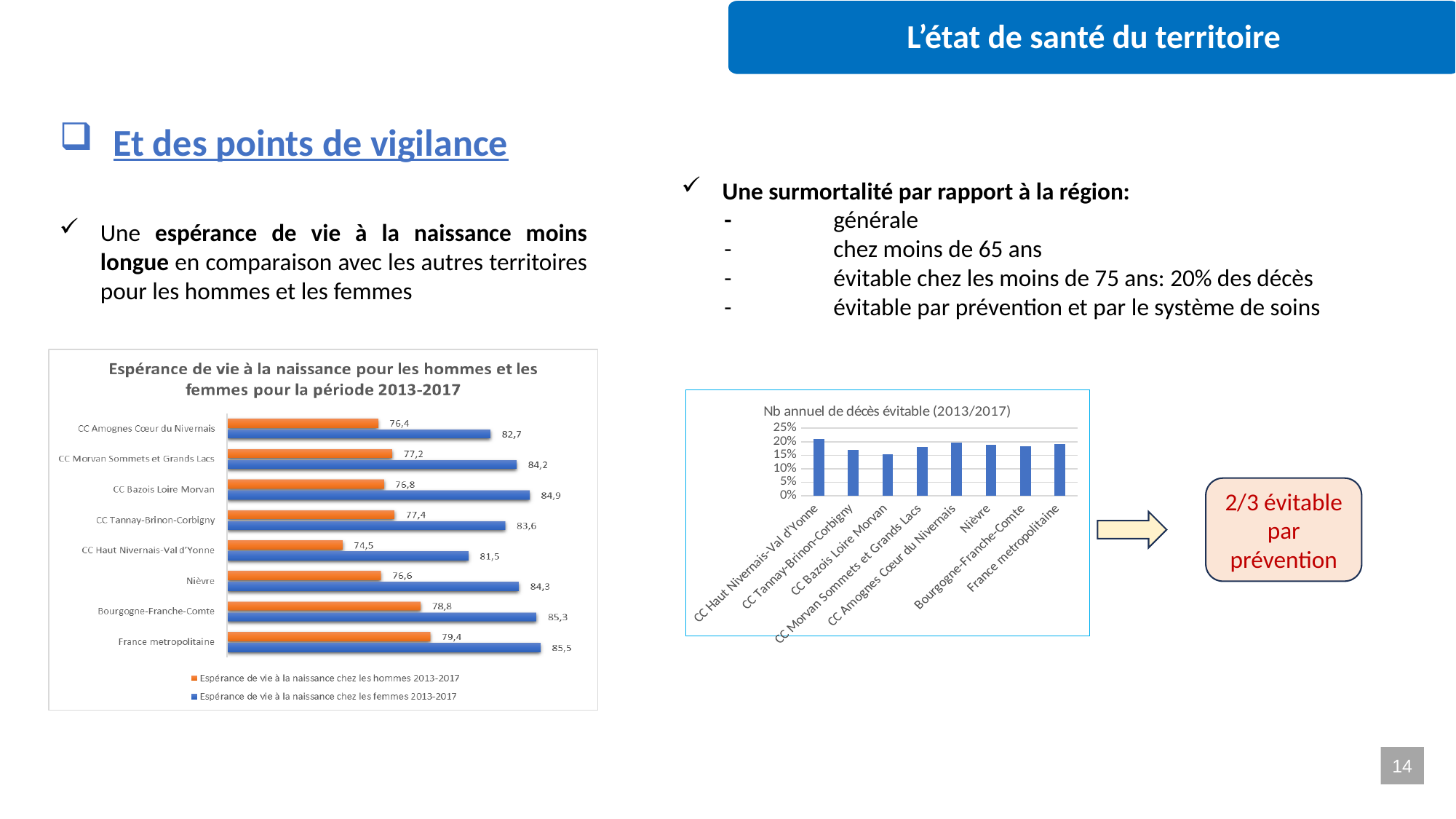
What type of chart is the 'Nb annuel de décès évitable (2013/2017)' chart? Bar chart How many territories are shown in the life expectancy chart? 8 In the life expectancy chart, which territory has the highest life expectancy for men? France metropolitaine In the life expectancy chart, which colour represents life expectancy for women? Blue In the life expectancy chart, what is the life expectancy at birth for women in France metropolitaine? 85,5 In the 'Nb annuel de décès évitable (2013/2017)' chart, is the value for CC Bazois Loire Morvan greater or less than 20%? less In the life expectancy chart, what is the life expectancy at birth for men in CC Haut Nivernais-Val d'Yonne? 74,5 In the life expectancy chart, which territory has the lowest life expectancy for women? CC Haut Nivernais-Val d'Yonne In the life expectancy chart, which has a higher life expectancy for men: CC Tannay-Brinon-Corbigny or CC Bazois Loire Morvan? CC Tannay-Brinon-Corbigny In the life expectancy chart, what is the difference between women's and men's life expectancy in Nièvre? 7,7 In the 'Nb annuel de décès évitable (2013/2017)' chart, which territory has the lowest value? CC Bazois Loire Morvan How many series does the legend of the life expectancy chart list? 2